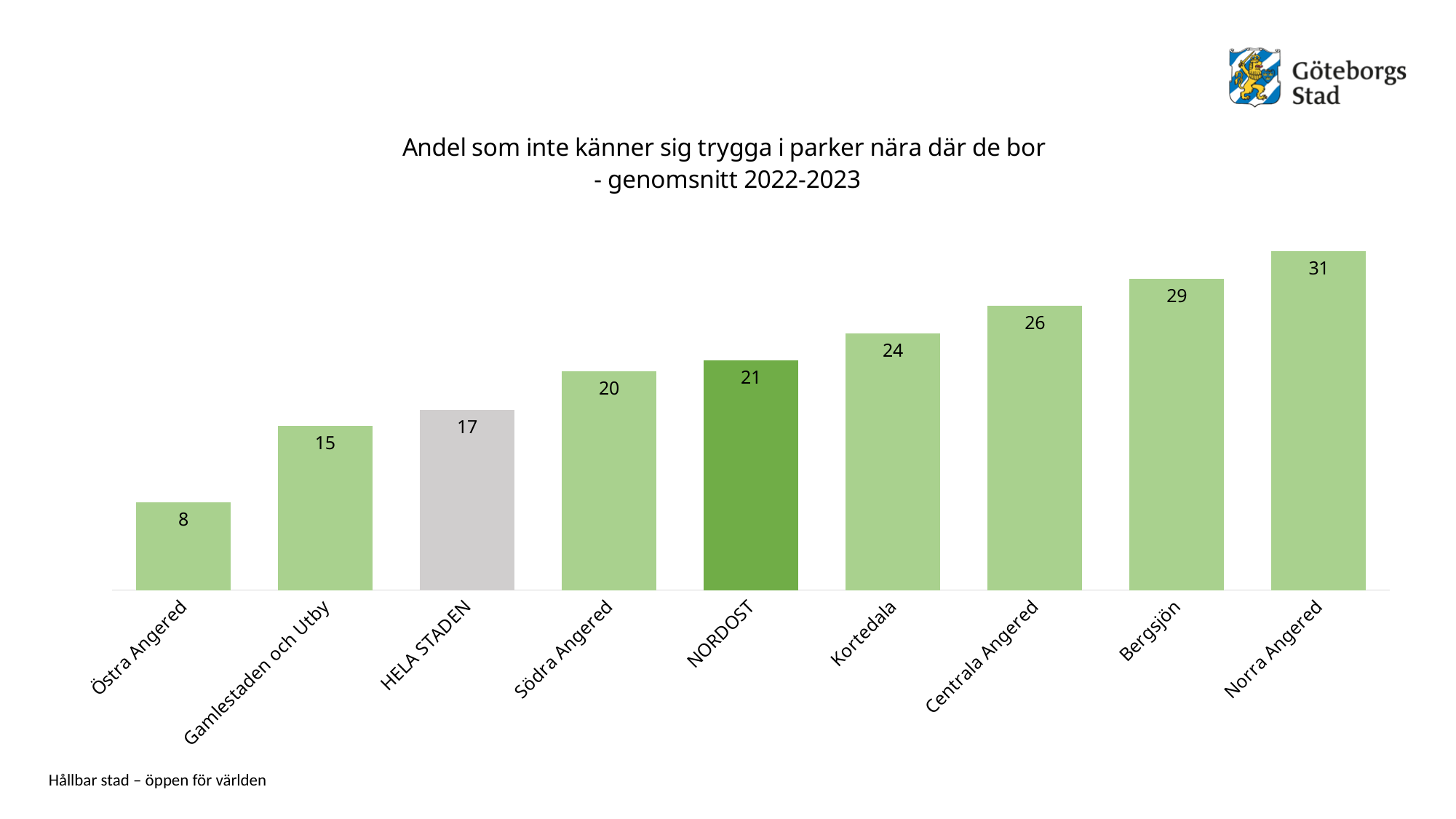
What is the value for HELA STADEN? 17 Do the values rise or fall from left to right along the x axis? Rise What is the difference between the values for Norra Angered and Östra Angered? 23 Which category has the lowest value? Östra Angered What kind of chart is shown on the slide? Bar chart Which category has the highest value? Norra Angered How many categories are shown in the chart? 9 What is the value for Östra Angered? 8 Which is larger, the value for Gamlestaden och Utby or the value for Södra Angered? Södra Angered What is the difference between the values for Centrala Angered and Kortedala? 2 What is the value for Bergsjön? 29 What is the value for NORDOST? 21